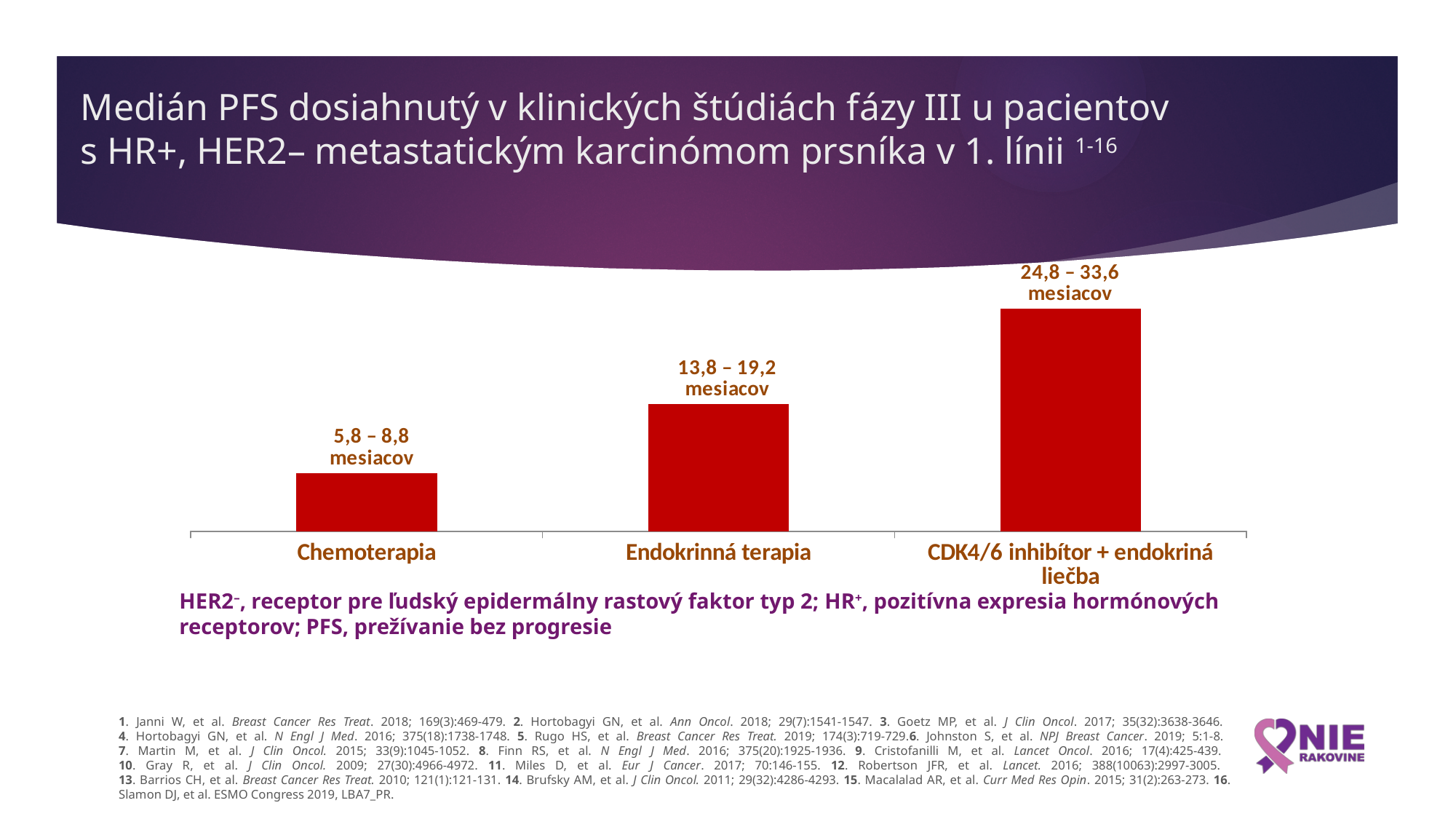
What range is shown as the data label for Endokrinná terapia? 13,8 – 19,2 mesiacov How many categories are shown on the x axis? 3 What colour are the bars in the chart? Red Which bar is taller, Endokrinná terapia or Chemoterapia? Endokrinná terapia Which bar is taller, Endokrinná terapia or CDK4/6 inhibítor + endokriná liečba? CDK4/6 inhibítor + endokriná liečba Which category has the highest bar? CDK4/6 inhibítor + endokriná liečba What kind of chart is shown on the slide? Bar chart What range is shown as the data label for CDK4/6 inhibítor + endokriná liečba? 24,8 – 33,6 mesiacov Do the bar values rise or fall from left to right along the x axis? Rise Which category has the lowest bar? Chemoterapia What is the lower bound of the range shown for Endokrinná terapia? 13,8 What range is shown as the data label for Chemoterapia? 5,8 – 8,8 mesiacov